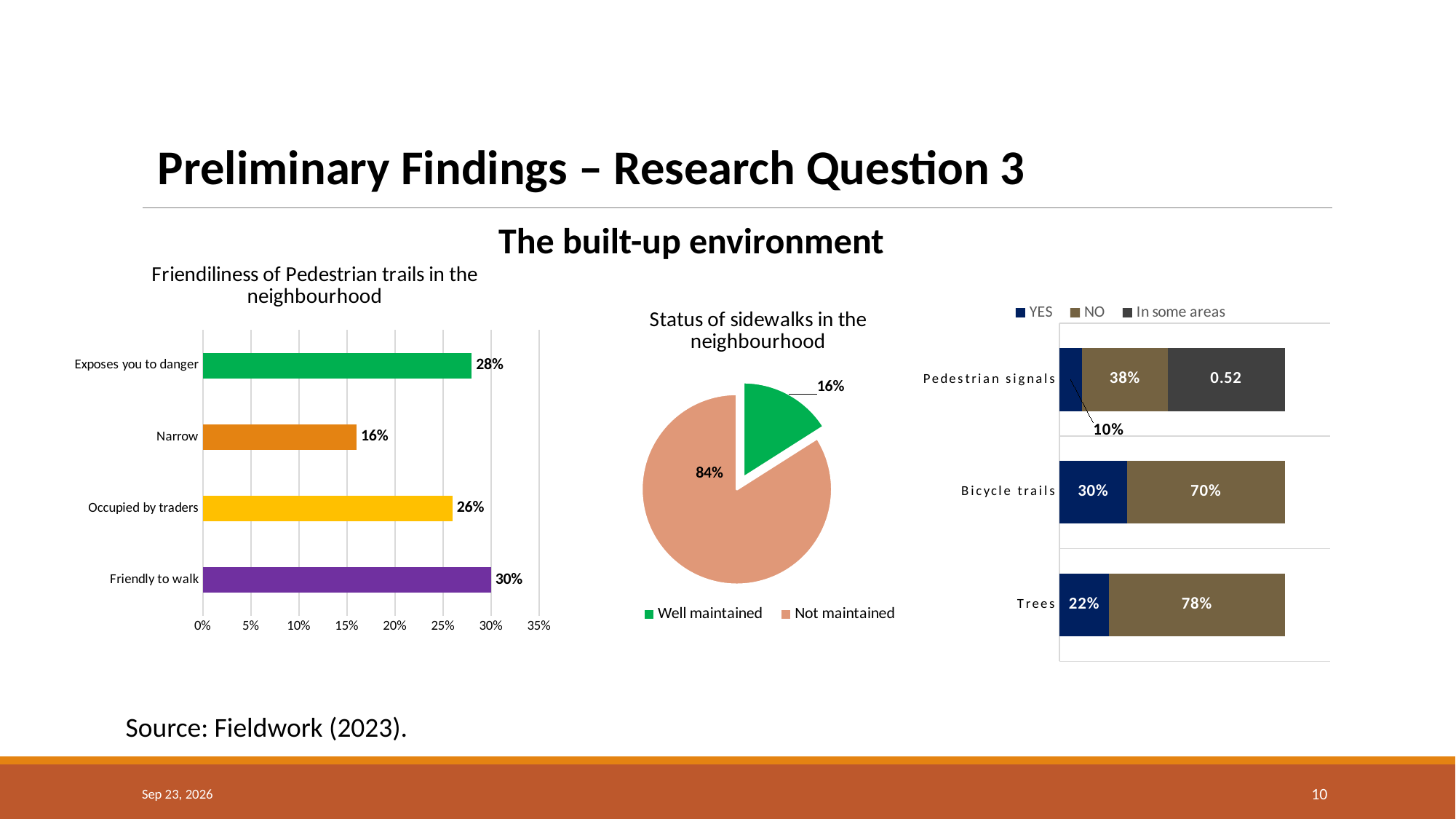
What kind of chart is 'Friendiliness of Pedestrian trails in the neighbourhood'? Bar chart In the 'Friendiliness of Pedestrian trails in the neighbourhood' chart, which category has the highest value? Friendly to walk In the 'Status of sidewalks in the neighbourhood' pie chart, what share is 'Not maintained'? 84% In the 'Friendiliness of Pedestrian trails in the neighbourhood' chart, which category has the lowest value? Narrow In the stacked bar chart on the right, what is the 'YES' value for 'Trees'? 22% How many series does the legend of the stacked bar chart on the right list? 3 In the stacked bar chart on the right, what is the 'NO' value for 'Bicycle trails'? 70% In the 'Friendiliness of Pedestrian trails in the neighbourhood' chart, what is the value for 'Narrow'? 16% In the 'Friendiliness of Pedestrian trails in the neighbourhood' chart, how many categories are shown? 4 In the stacked bar chart on the right, what is the 'In some areas' value for 'Pedestrian signals'? 0.52 In the 'Status of sidewalks in the neighbourhood' pie chart, which slice is larger, 'Well maintained' or 'Not maintained'? Not maintained In the 'Friendiliness of Pedestrian trails in the neighbourhood' chart, what is the difference between 'Exposes you to danger' and 'Occupied by traders'? 2%